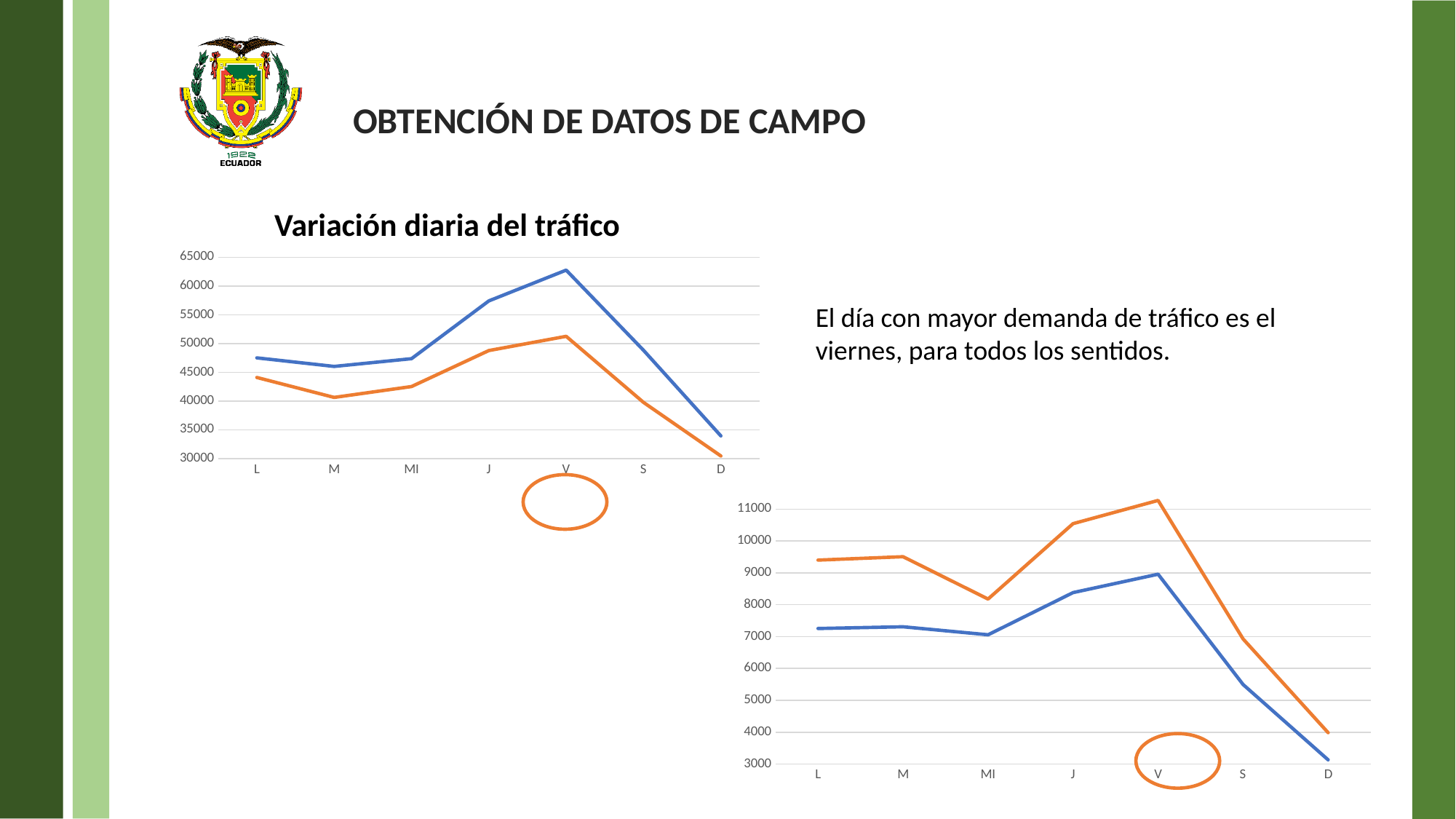
In the chart at the bottom right of the slide, on which day does the orange line reach its highest value? V In the chart titled 'Variación diaria del tráfico', is the blue line's value at V greater or less than 60000? greater In the chart titled 'Variación diaria del tráfico', which line is higher at J, the blue line or the orange line? the blue line In the chart at the bottom right of the slide, which line is higher at MI, the blue line or the orange line? the orange line In the chart at the bottom right of the slide, on which day does the blue line reach its lowest value? D What kind of chart is the chart titled 'Variación diaria del tráfico'? line chart In the chart titled 'Variación diaria del tráfico', do the values rise or fall from V to D? fall In the chart at the bottom right of the slide, is the blue line's value at D greater or less than 4000? less In the chart titled 'Variación diaria del tráfico', is the orange line's value at M greater or less than 45000? less In the chart titled 'Variación diaria del tráfico', on which day does the blue line reach its highest value? V In the chart titled 'Variación diaria del tráfico', on which day does the orange line reach its lowest value? D How many categories are shown on the x axis of the chart titled 'Variación diaria del tráfico'? 7